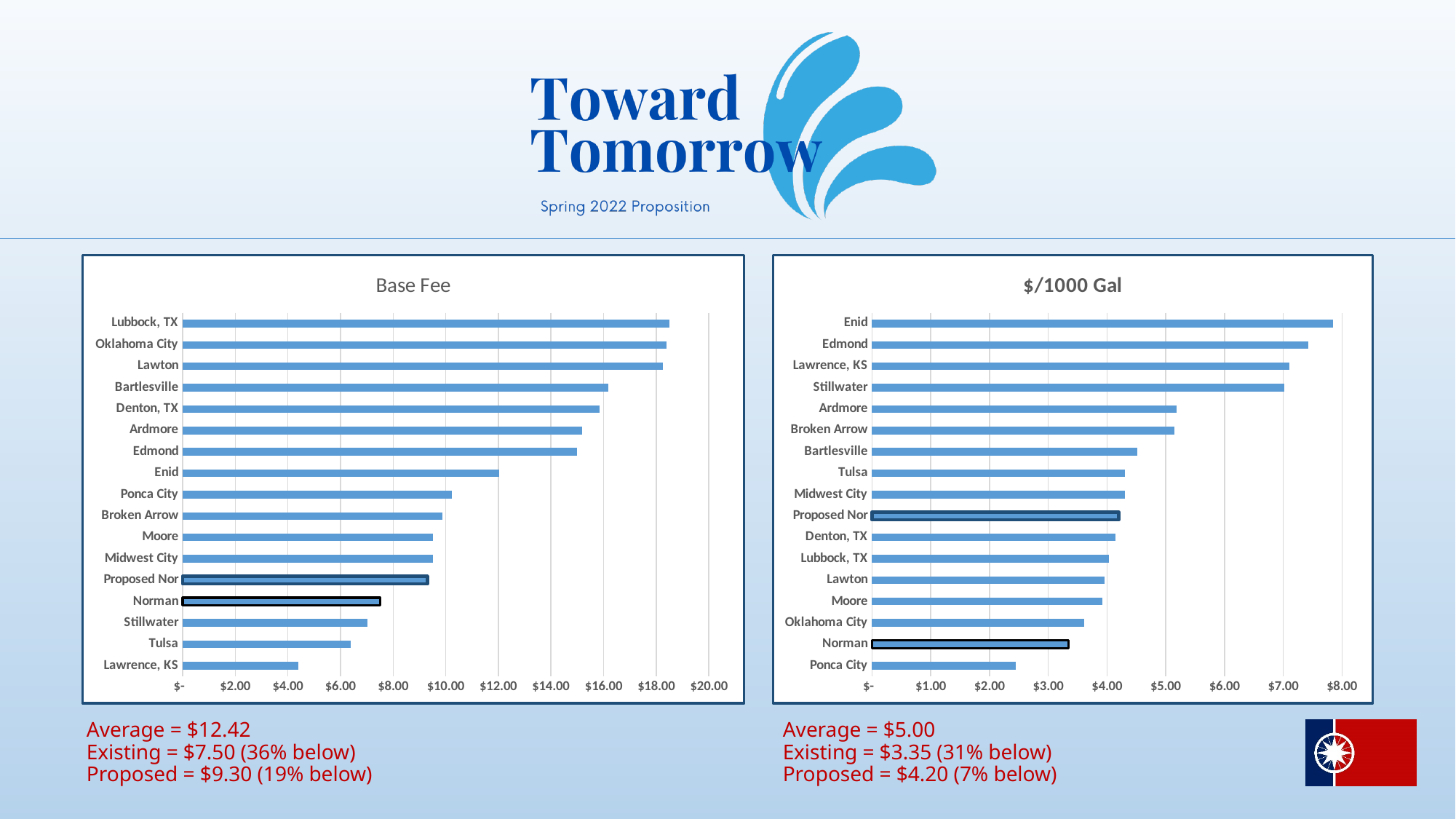
In the Base Fee chart, is the value for Ardmore greater or less than $14.00? greater In the Base Fee chart, which is larger, Lawton or Bartlesville? Lawton In the Base Fee chart, what is the value for Norman? $7.50 In the $/1000 Gal chart, is the value for Bartlesville greater or less than $4.00? greater In the Base Fee chart, what is the difference between the Proposed Nor value and the Norman value? $1.80 In the $/1000 Gal chart, which category has the lowest value? Ponca City In the Base Fee chart, which category has the lowest value? Lawrence, KS In the $/1000 Gal chart, which category has the highest value? Enid In the $/1000 Gal chart, what is the value for Norman? $3.35 What type of chart is the Base Fee chart? bar chart In the Base Fee chart, what is the value for Proposed Nor? $9.30 In the Base Fee chart, how many cities/categories are plotted? 17